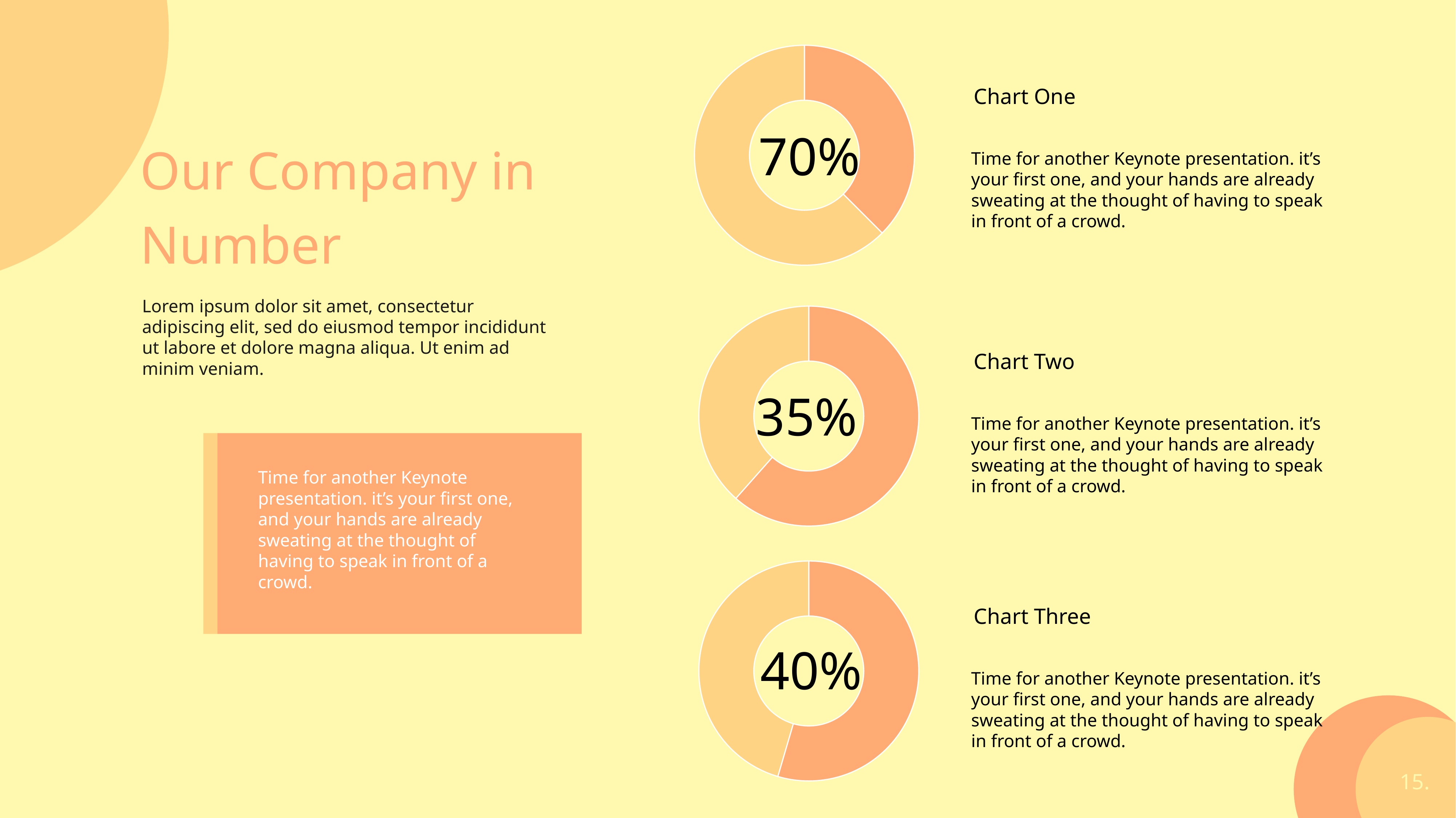
What kind of chart is Chart One? Donut chart What is the title of the slide containing the three donut charts? Our Company in Number What percentage is shown in the centre of Chart Two? 35% Which shows a larger percentage, Chart One or Chart Three? Chart One What is the difference between the percentage in Chart Three and the percentage in Chart Two? 5% How many donut charts are on the slide? 3 What percentage is shown in the centre of Chart One? 70% Which of the three charts shows the highest percentage? Chart One What is the difference between the percentage in Chart One and the percentage in Chart Two? 35% Which shows a larger percentage, Chart Two or Chart Three? Chart Three Which of the three charts shows the lowest percentage? Chart Two What percentage is shown in the centre of Chart Three? 40%